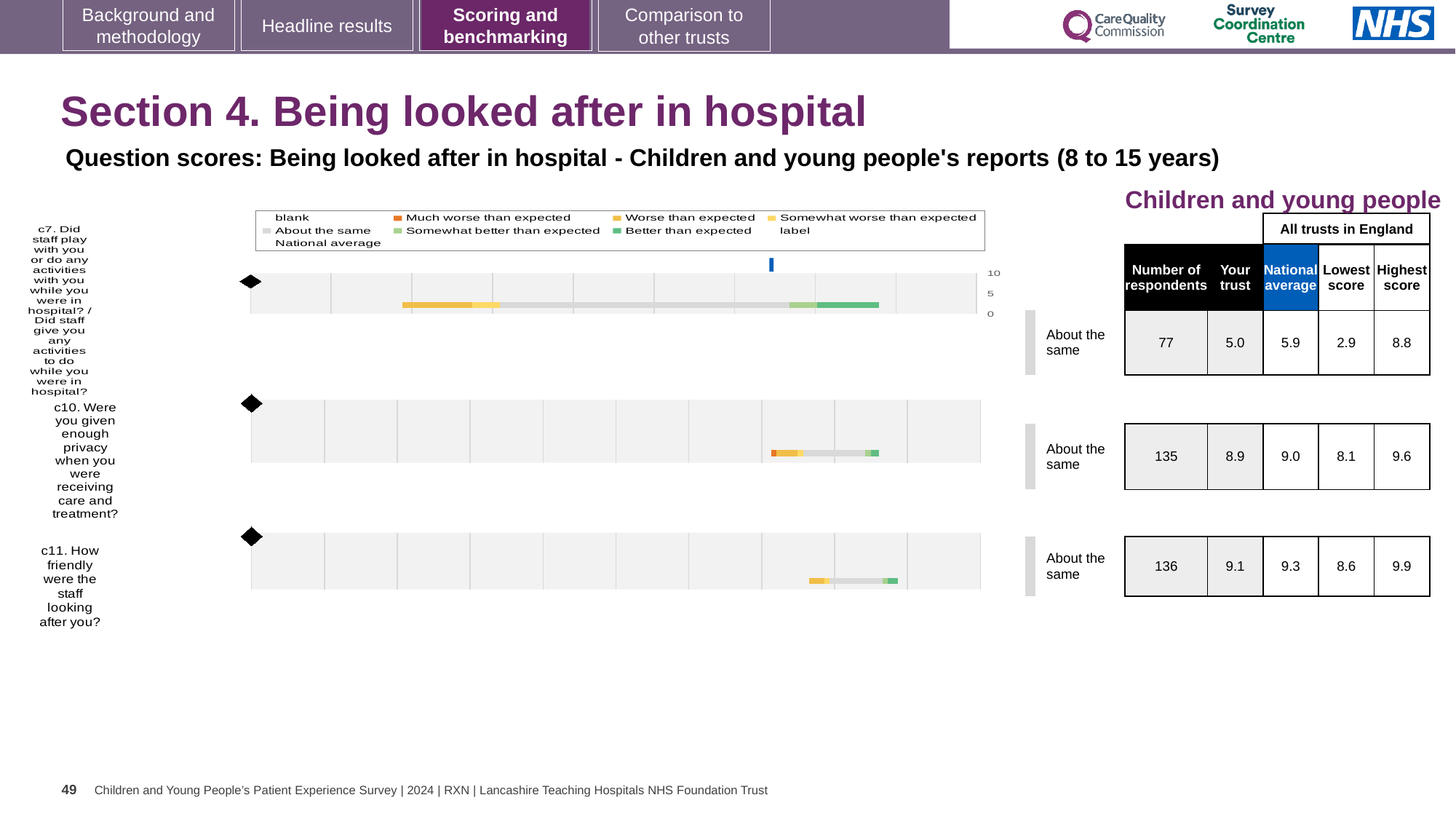
What kind of chart is used to show the question scores on this slide? Bar chart For question c7 (Did staff play with you or do any activities with you while you were in hospital?), what is the 'Your trust' score? 5.0 For question c7, what is the difference between the highest score and the lowest score across all trusts in England? 5.9 For question c10, which is larger: the 'Your trust' score or the national average? National average For question c11, what is the difference between the national average and the 'Your trust' score? 0.2 How many questions (chart rows) are shown on the slide? 3 What benchmark category is shown for question c7? About the same How many respondents answered question c11 (How friendly were the staff looking after you?)? 136 What colour does the legend use for 'Better than expected'? Green Which question has the highest 'Your trust' score? c11. How friendly were the staff looking after you? For question c10 (Were you given enough privacy when you were receiving care and treatment?), what is the national average score? 9.0 Which question has the lowest 'Your trust' score? c7. Did staff play with you or do any activities with you while you were in hospital?